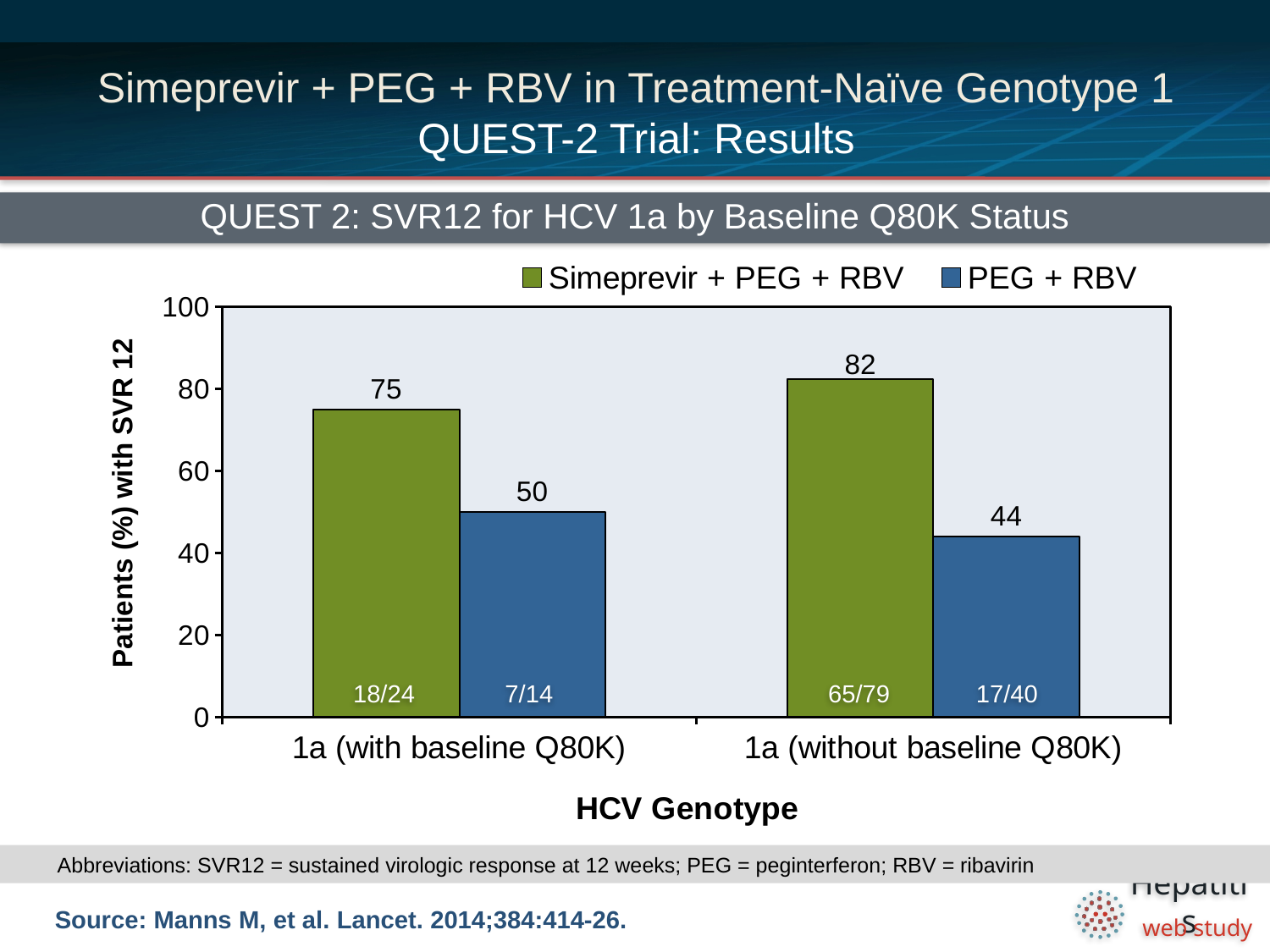
Which bar has the highest SVR12 rate on the chart? Simeprevir + PEG + RBV, 1a (without baseline Q80K) What fraction of patients is shown inside the Simeprevir + PEG + RBV bar for 1a (without baseline Q80K)? 65/79 Which bar has the lowest SVR12 rate on the chart? PEG + RBV, 1a (without baseline Q80K) What is the label of the y axis? Patients (%) with SVR 12 How many series does the legend list? 2 How many HCV genotype categories are shown on the x axis? 2 Which is larger: the Simeprevir + PEG + RBV rate for 1a (with baseline Q80K) or for 1a (without baseline Q80K)? 1a (without baseline Q80K) What fraction of patients is shown inside the PEG + RBV bar for 1a (with baseline Q80K)? 7/14 What is the difference in SVR12 rate between Simeprevir + PEG + RBV and PEG + RBV in the 1a (without baseline Q80K) group? 38 What is the SVR12 rate for Simeprevir + PEG + RBV in the 1a (with baseline Q80K) group? 75 What is the SVR12 rate for PEG + RBV in the 1a (without baseline Q80K) group? 44 What kind of chart is shown on the slide? Bar chart